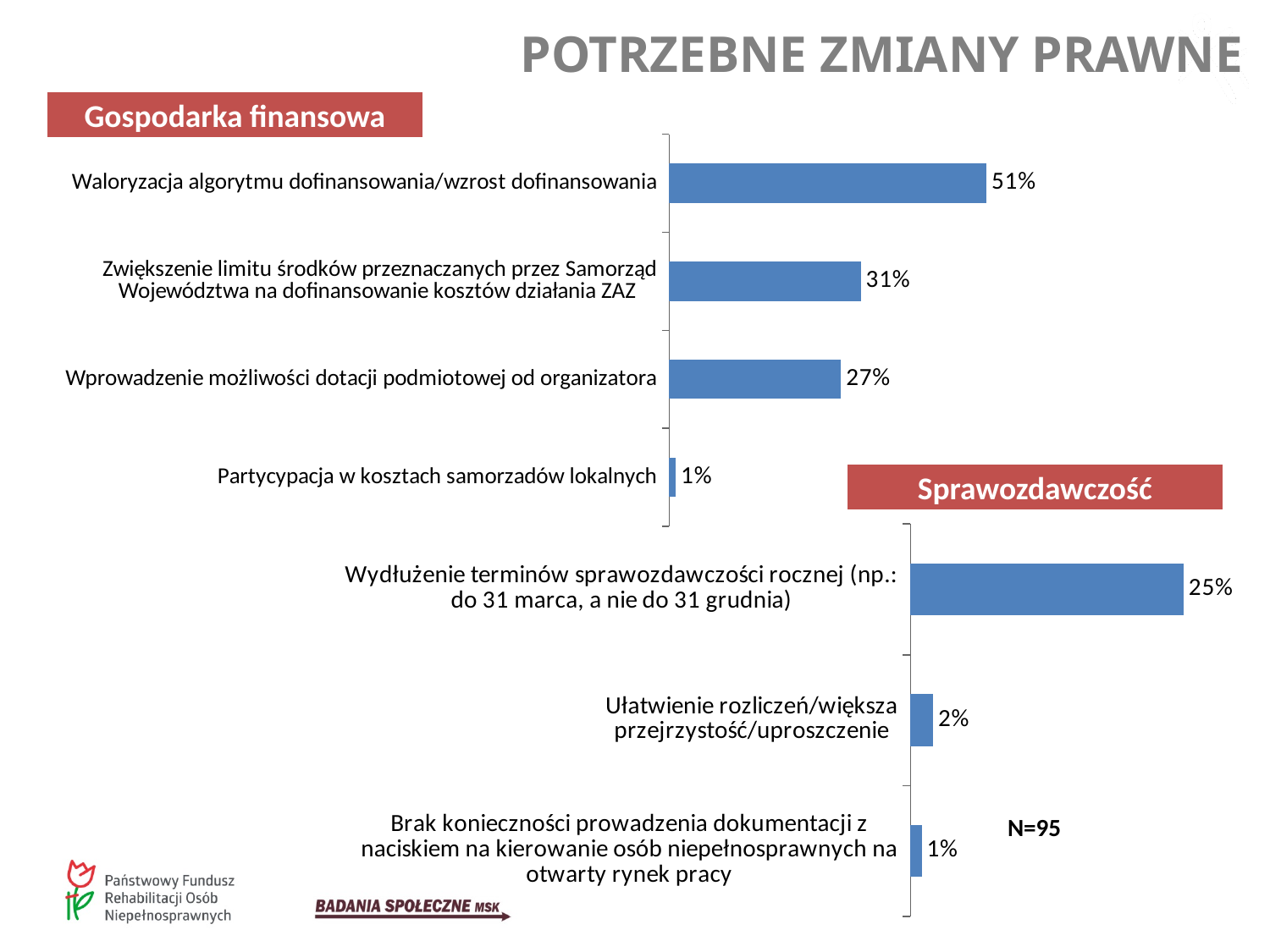
In the 'Sprawozdawczość' chart, what is the difference between the values for 'Wydłużenie terminów sprawozdawczości rocznej' and 'Ułatwienie rozliczeń/większa przejrzystość/uproszczenie'? 23% In the 'Gospodarka finansowa' chart, how many categories are shown? 4 What type of chart is the 'Gospodarka finansowa' chart? Bar chart In the 'Gospodarka finansowa' chart, which category has the lowest value? Partycypacja w kosztach samorzadów lokalnych In the 'Gospodarka finansowa' chart, what is the difference between the values for 'Waloryzacja algorytmu dofinansowania/wzrost dofinansowania' and 'Zwiększenie limitu środków przeznaczanych przez Samorząd Województwa na dofinansowanie kosztów działania ZAZ'? 20% In the 'Sprawozdawczość' chart, what is the value for 'Ułatwienie rozliczeń/większa przejrzystość/uproszczenie'? 2% In the 'Gospodarka finansowa' chart, what is the value for 'Wprowadzenie możliwości dotacji podmiotowej od organizatora'? 27% Which is larger: the value for 'Wprowadzenie możliwości dotacji podmiotowej od organizatora' in the 'Gospodarka finansowa' chart or the value for 'Wydłużenie terminów sprawozdawczości rocznej' in the 'Sprawozdawczość' chart? Wprowadzenie możliwości dotacji podmiotowej od organizatora In the 'Sprawozdawczość' chart, what is the value for 'Wydłużenie terminów sprawozdawczości rocznej (np.: do 31 marca, a nie do 31 grudnia)'? 25% In the 'Sprawozdawczość' chart, which category has the highest value? Wydłużenie terminów sprawozdawczości rocznej (np.: do 31 marca, a nie do 31 grudnia) In the 'Gospodarka finansowa' chart, what is the value for 'Waloryzacja algorytmu dofinansowania/wzrost dofinansowania'? 51% In the 'Sprawozdawczość' chart, how many categories are shown? 3